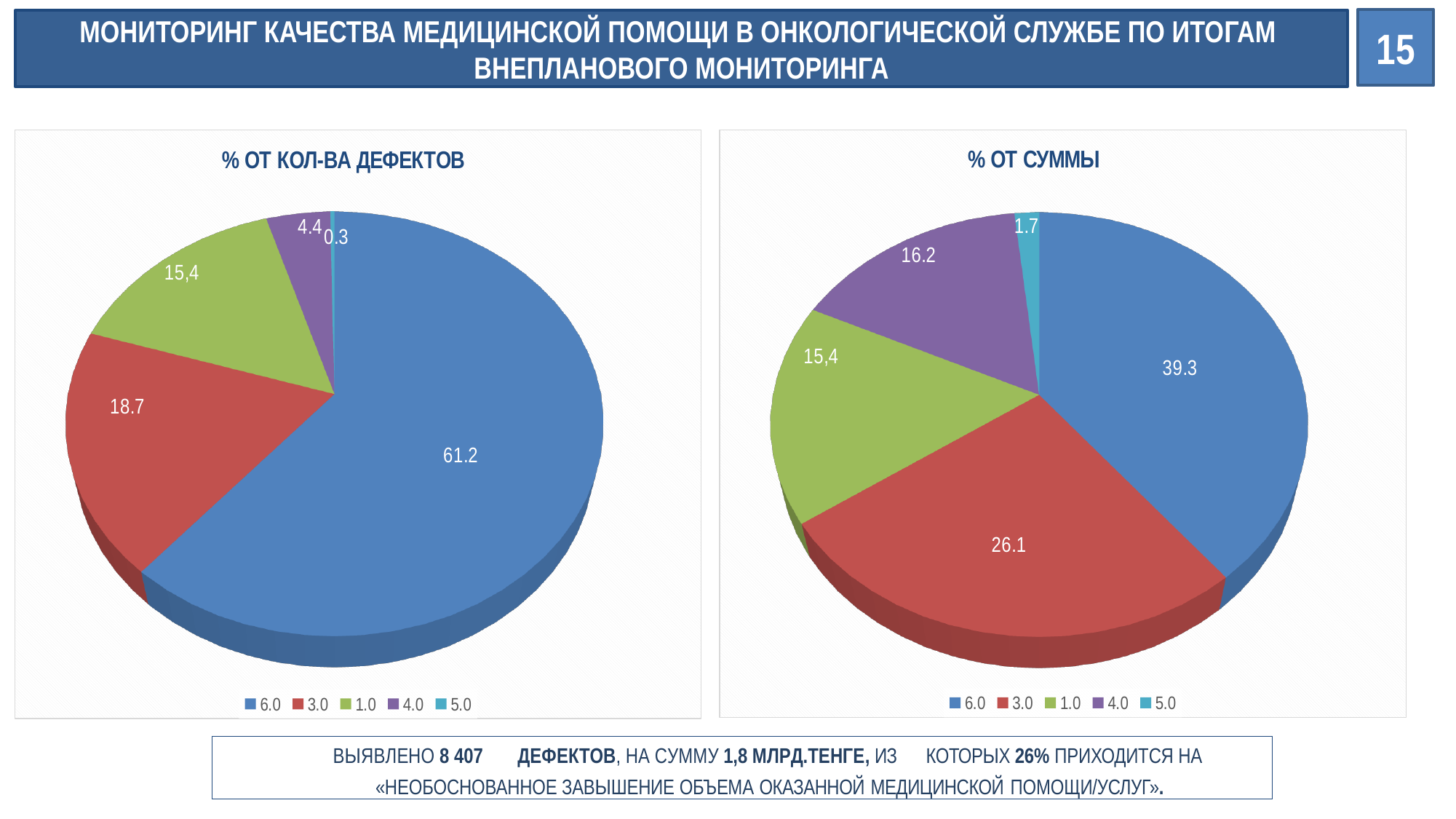
What type of chart is the chart titled "% ОТ КОЛ-ВА ДЕФЕКТОВ"? Pie chart In the chart titled "% ОТ КОЛ-ВА ДЕФЕКТОВ", which category has the largest slice? 6.0 In the chart titled "% ОТ СУММЫ", which category has the smallest slice? 5.0 In the chart titled "% ОТ СУММЫ", what is the value of the slice for category 5.0? 1.7 In the chart titled "% ОТ КОЛ-ВА ДЕФЕКТОВ", which is larger: the value for category 3.0 or the value for category 1.0? 3.0 In the chart titled "% ОТ КОЛ-ВА ДЕФЕКТОВ", what is the value of the slice for category 3.0? 18.7 In the chart titled "% ОТ СУММЫ", what is the value of the slice for category 4.0? 16.2 In the chart titled "% ОТ КОЛ-ВА ДЕФЕКТОВ", which category has the smallest slice? 5.0 In the chart titled "% ОТ КОЛ-ВА ДЕФЕКТОВ", what is the value of the slice for category 6.0? 61.2 In the chart titled "% ОТ СУММЫ", what is the difference between the values for category 6.0 and category 3.0? 13.2 How many slices does the chart titled "% ОТ СУММЫ" have? 5 In the chart titled "% ОТ СУММЫ", what colour is the slice for category 3.0? Red